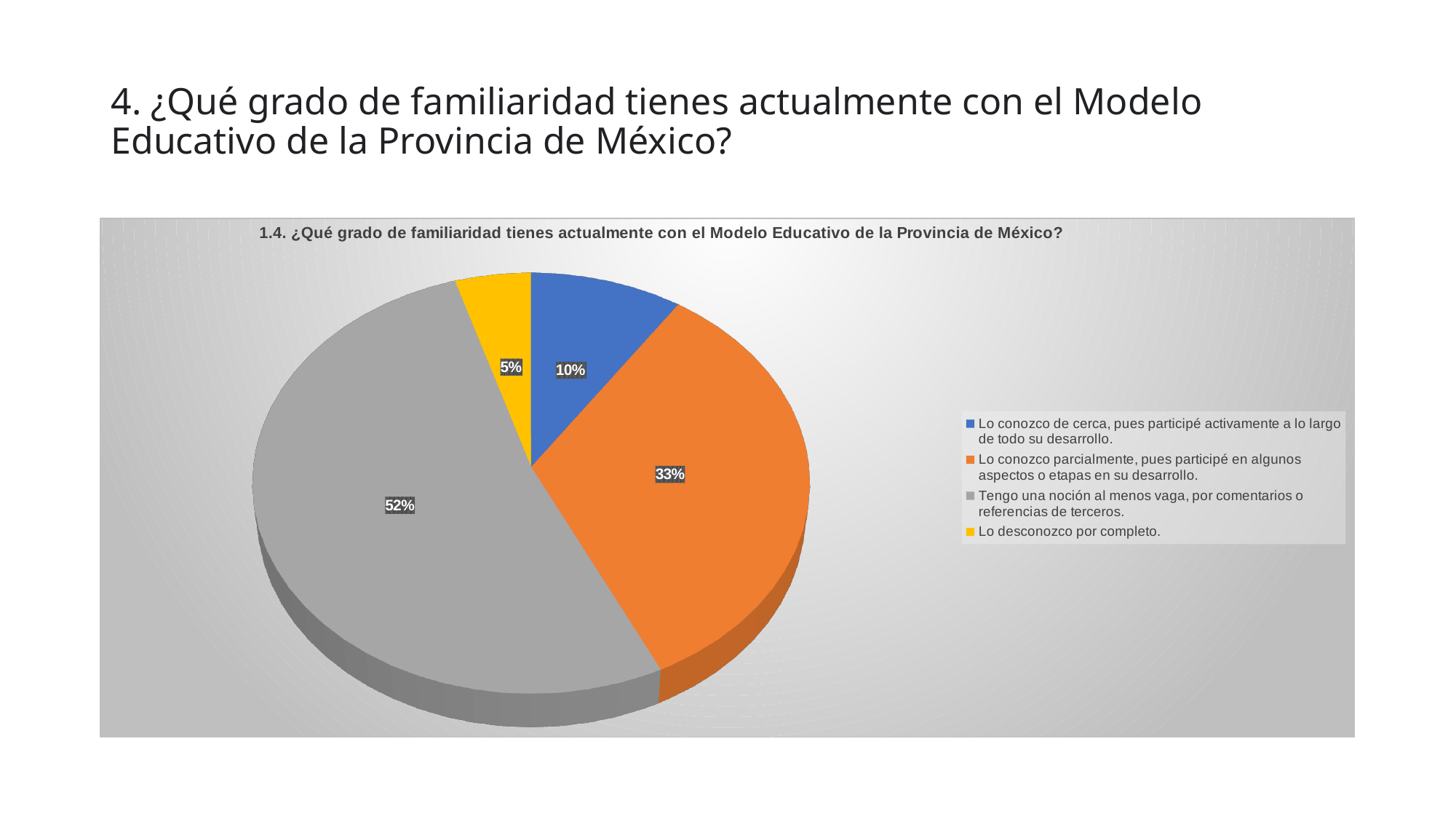
What share of the pie is labelled "Tengo una noción al menos vaga, por comentarios o referencias de terceros."? 52% Which category has the smallest slice of the pie? Lo desconozco por completo. How many categories does the pie chart have? 4 What share of the pie is labelled "Lo desconozco por completo."? 5% Which is larger: the "Lo conozco de cerca" slice or the "Lo desconozco por completo" slice? Lo conozco de cerca, pues participé activamente a lo largo de todo su desarrollo. What is the difference in percentage points between the "Tengo una noción al menos vaga" slice and the "Lo conozco parcialmente" slice? 19% What is the title of the chart? 1.4. ¿Qué grado de familiaridad tienes actualmente con el Modelo Educativo de la Provincia de México? What share of the pie is labelled "Lo conozco parcialmente, pues participé en algunos aspectos o etapas en su desarrollo."? 33% What colour is the slice for "Lo desconozco por completo."? Yellow Which category has the largest slice of the pie? Tengo una noción al menos vaga, por comentarios o referencias de terceros. What share of the pie is labelled "Lo conozco de cerca, pues participé activamente a lo largo de todo su desarrollo."? 10% What kind of chart is shown on the slide? Pie chart